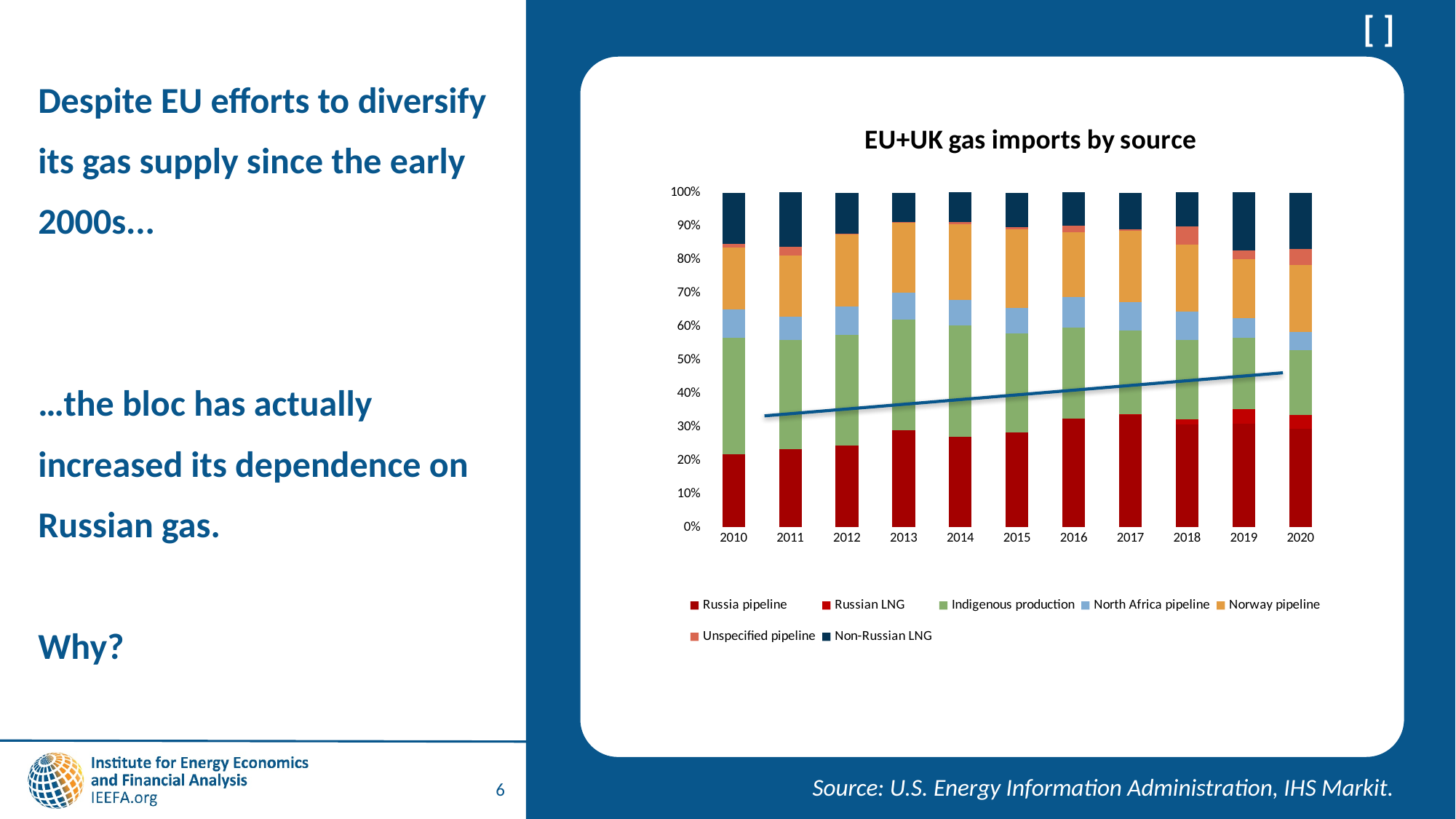
Which year has the larger Russia pipeline share, 2010 or 2019? 2019 Which series is plotted at the top of each stacked bar? Non-Russian LNG Is the Russia pipeline share in 2012 greater or less than 30%? less Is the Russia pipeline share in 2010 greater or less than 30%? less Does the Russia pipeline share generally rise or fall from 2010 to 2020? rise What kind of chart is shown on the slide? Stacked bar chart What is the title of the chart? EU+UK gas imports by source What is the first year shown on the x axis? 2010 How many years are shown along the x axis of the chart? 11 How many series does the chart's legend list? 7